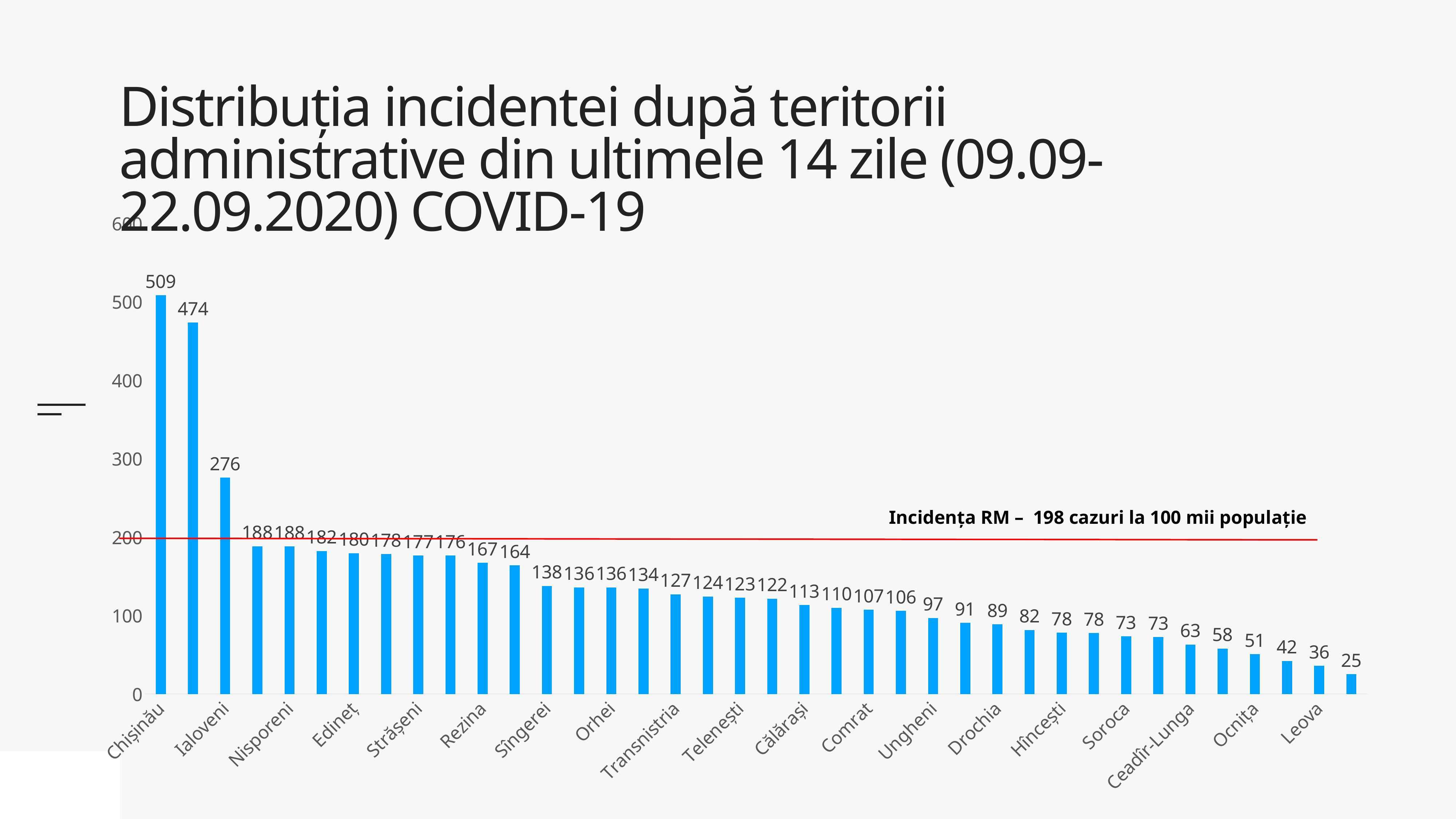
What kind of chart is shown on the slide? bar chart Which territory has the highest incidence in the chart? Chișinău Is the value for Chișinău greater or less than 500? greater What national incidence value (Incidența RM) is marked by the red line? 198 cazuri la 100 mii populație What is the difference between the values for Chișinău and Ialoveni? 233 What is the incidence value shown for Leova? 36 What is the incidence value shown for Chișinău? 509 What is the lowest value labelled on any bar in the chart? 25 What is the incidence value shown for Ialoveni? 276 Which has a higher value, Ialoveni or Nisporeni? Ialoveni Do the values rise or fall from left to right along the x axis? fall What is the incidence value shown for Nisporeni? 188